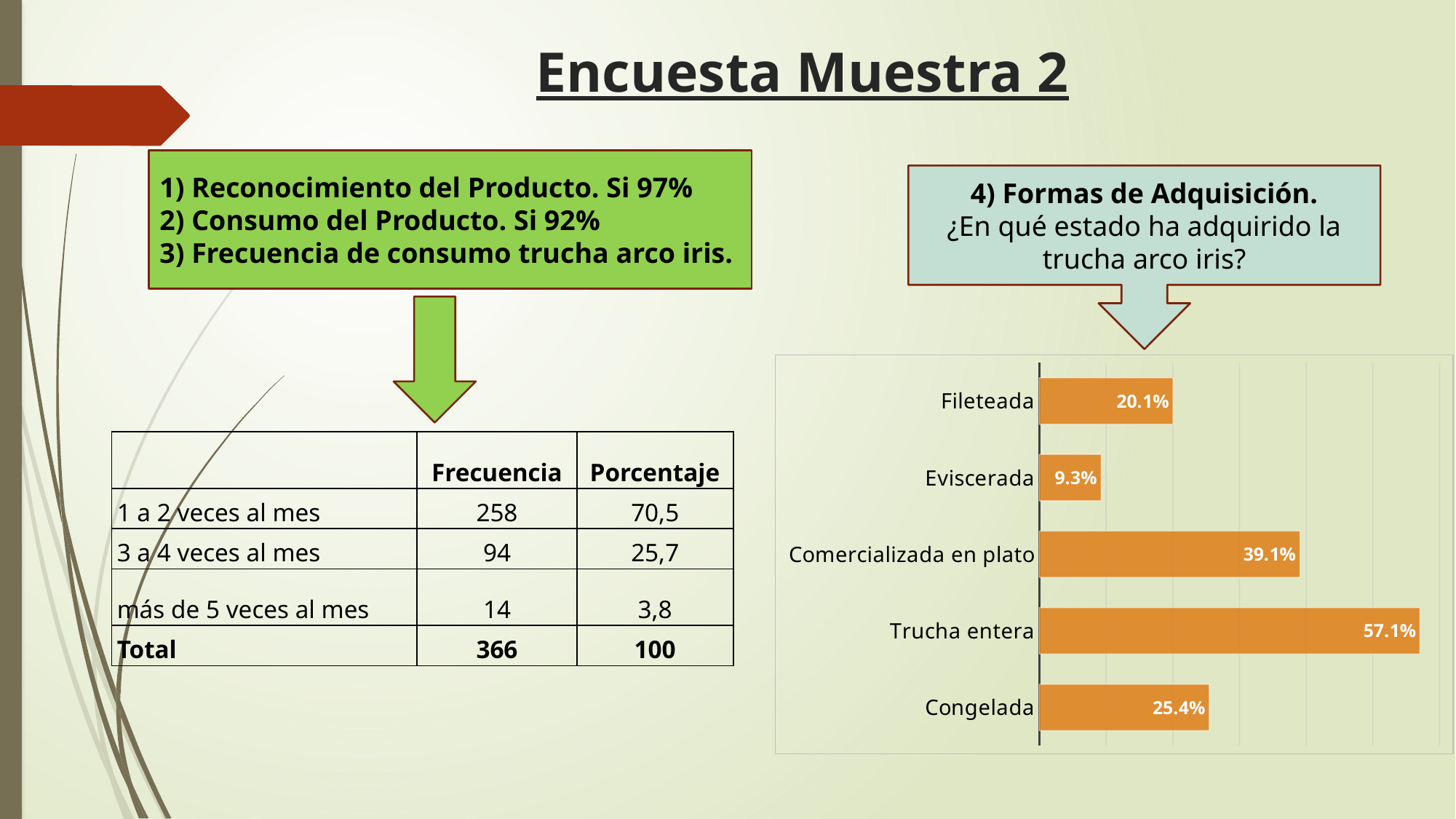
What is the value for Congelada? 25.4% What is the value for Comercializada en plato? 39.1% What is the value for Trucha entera? 57.1% What is the difference between the values for Trucha entera and Comercializada en plato? 18.0% How many categories are shown in the chart? 5 Which category has the lowest value? Eviscerada What type of chart is shown on the slide? bar chart Which category has the highest value? Trucha entera What is the value for Fileteada? 20.1% What is the value for Eviscerada? 9.3% What colour are the bars in the chart? orange Which is larger, the value for Congelada or the value for Fileteada? Congelada